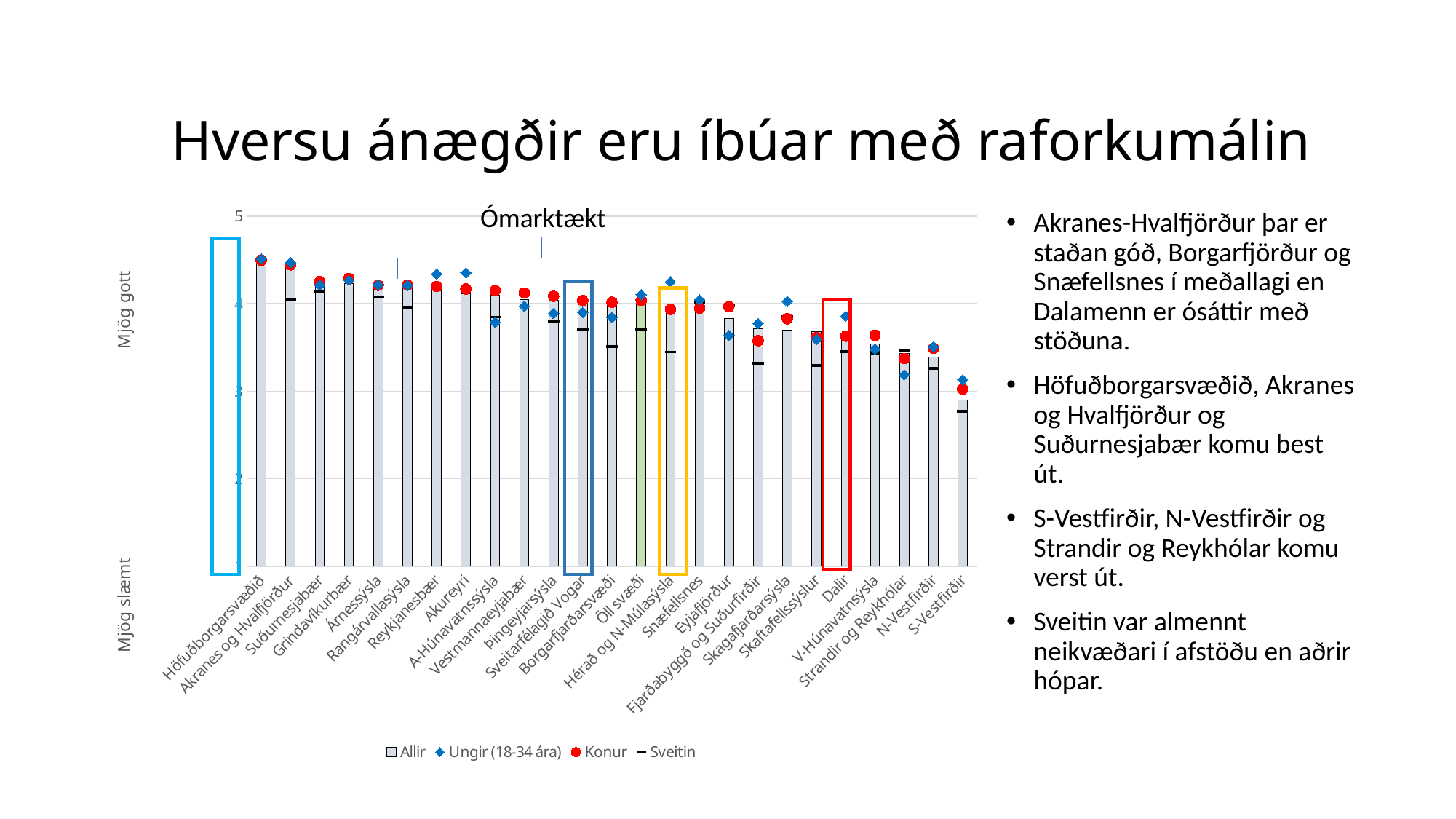
Which region has the lowest 'Allir' bar in the chart? S-Vestfirðir How many series does the chart legend list? 4 Is the 'Allir' value for Höfuðborgarsvæðið greater or less than 4? greater Which series in the legend is marked with a red circle? Konur Is the 'Sveitin' value for S-Vestfirðir greater or less than 3? less Which has the larger 'Allir' bar, Suðurnesjabær or Dalir? Suðurnesjabær Do the 'Allir' bars generally rise or fall from left to right along the x axis? fall What kind of chart is shown on the slide? Bar chart Is the 'Ungir (18-34 ára)' value for Akureyri greater or less than 4? greater What is the title of the slide containing the chart? Hversu ánægðir eru íbúar með raforkumálin How many regions (categories) are shown along the x axis of the chart? 25